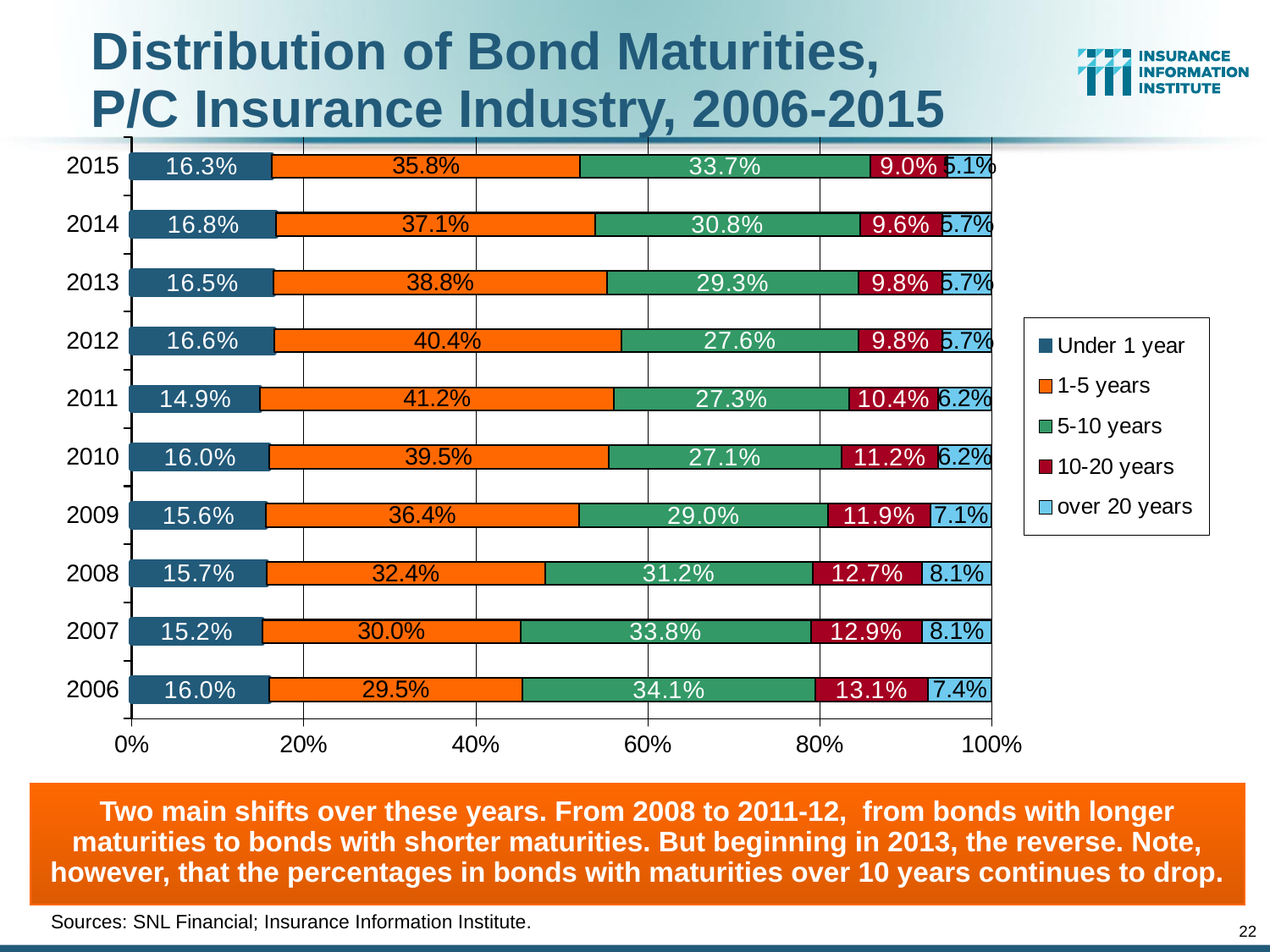
How many series does the legend list? 5 Which year had the lowest share of bonds with 10-20 year maturities? 2015 How many years are shown on the chart? 10 Which year had the highest share of bonds with 1-5 year maturities? 2011 What is the title of the chart? Distribution of Bond Maturities, P/C Insurance Industry, 2006-2015 Does the share of bonds with 10-20 year maturities rise or fall from 2006 to 2015? Fall What kind of chart is shown on the slide? Stacked bar chart What share of bonds had maturities of 5-10 years in 2006? 34.1% What share of bonds had maturities under 1 year in 2014? 16.8% What share of bonds had maturities of 1-5 years in 2011? 41.2% By how many percentage points did the 10-20 years share fall from 2006 to 2015? 4.1 percentage points Which year had a larger share of 5-10 year maturities, 2008 or 2013? 2008